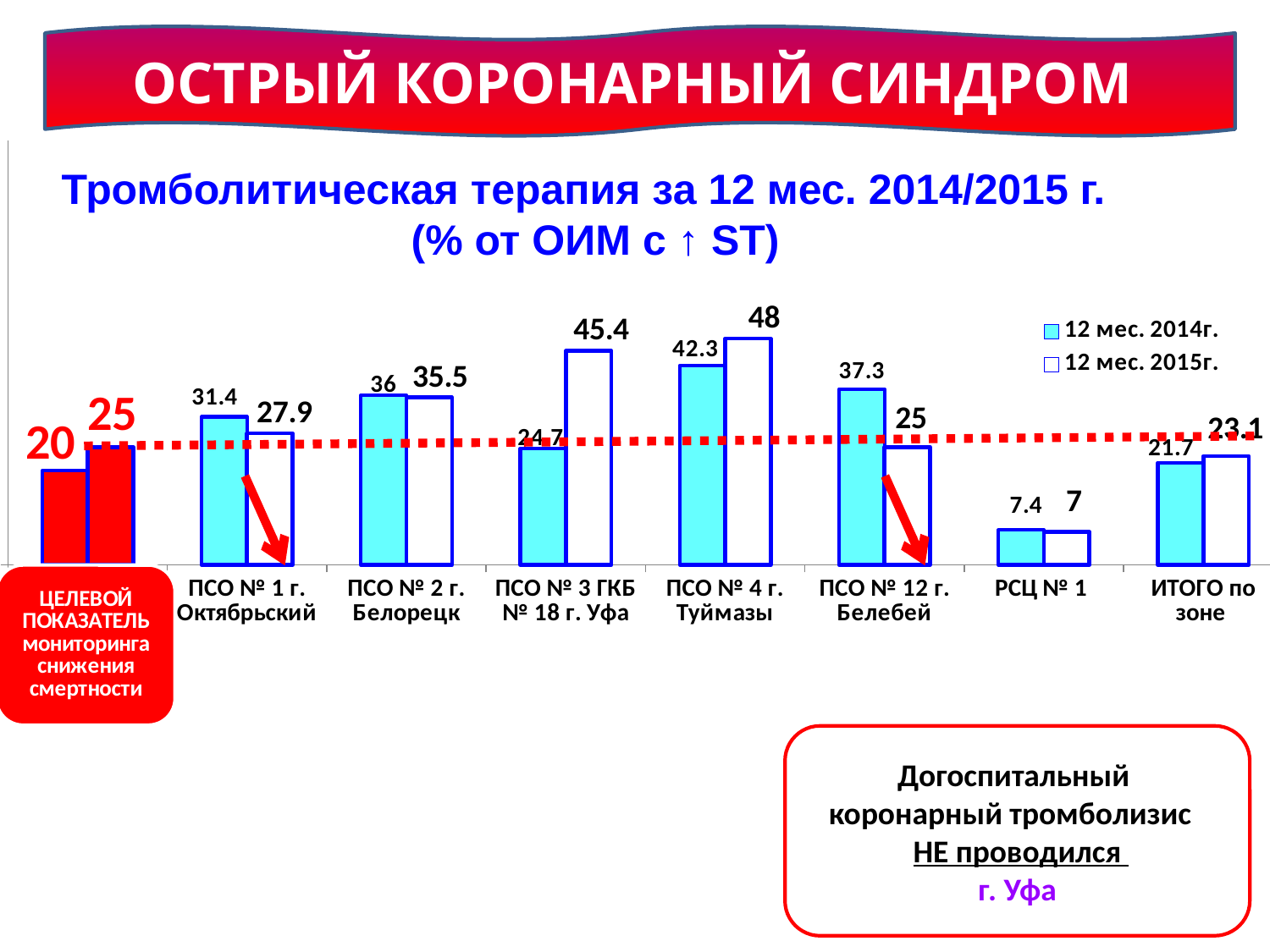
What is the value for ПСО № 12 г. Белебей in the 12 мес. 2014г. series? 37.3 What is the difference between the 12 мес. 2015г. and 12 мес. 2014г. values for ПСО № 3 ГКБ № 18 г. Уфа? 20.7 How many series does the legend list? 2 Which is larger for ПСО № 12 г. Белебей: the 12 мес. 2014г. value or the 12 мес. 2015г. value? 12 мес. 2014г. What kind of chart is shown on the slide? Bar chart What is the value for ПСО № 4 г. Туймазы in the 12 мес. 2015г. series? 48 Which category has the highest value in the 12 мес. 2015г. series? ПСО № 4 г. Туймазы Which category has the lowest value in the 12 мес. 2014г. series? РСЦ № 1 What is the value for ПСО № 3 ГКБ № 18 г. Уфа in the 12 мес. 2014г. series? 24.7 What are the two series names listed in the legend? 12 мес. 2014г. and 12 мес. 2015г. What is the value for ИТОГО по зоне in the 12 мес. 2015г. series? 23.1 What is the difference between the 12 мес. 2014г. and 12 мес. 2015г. values for ПСО № 1 г. Октябрьский? 3.5